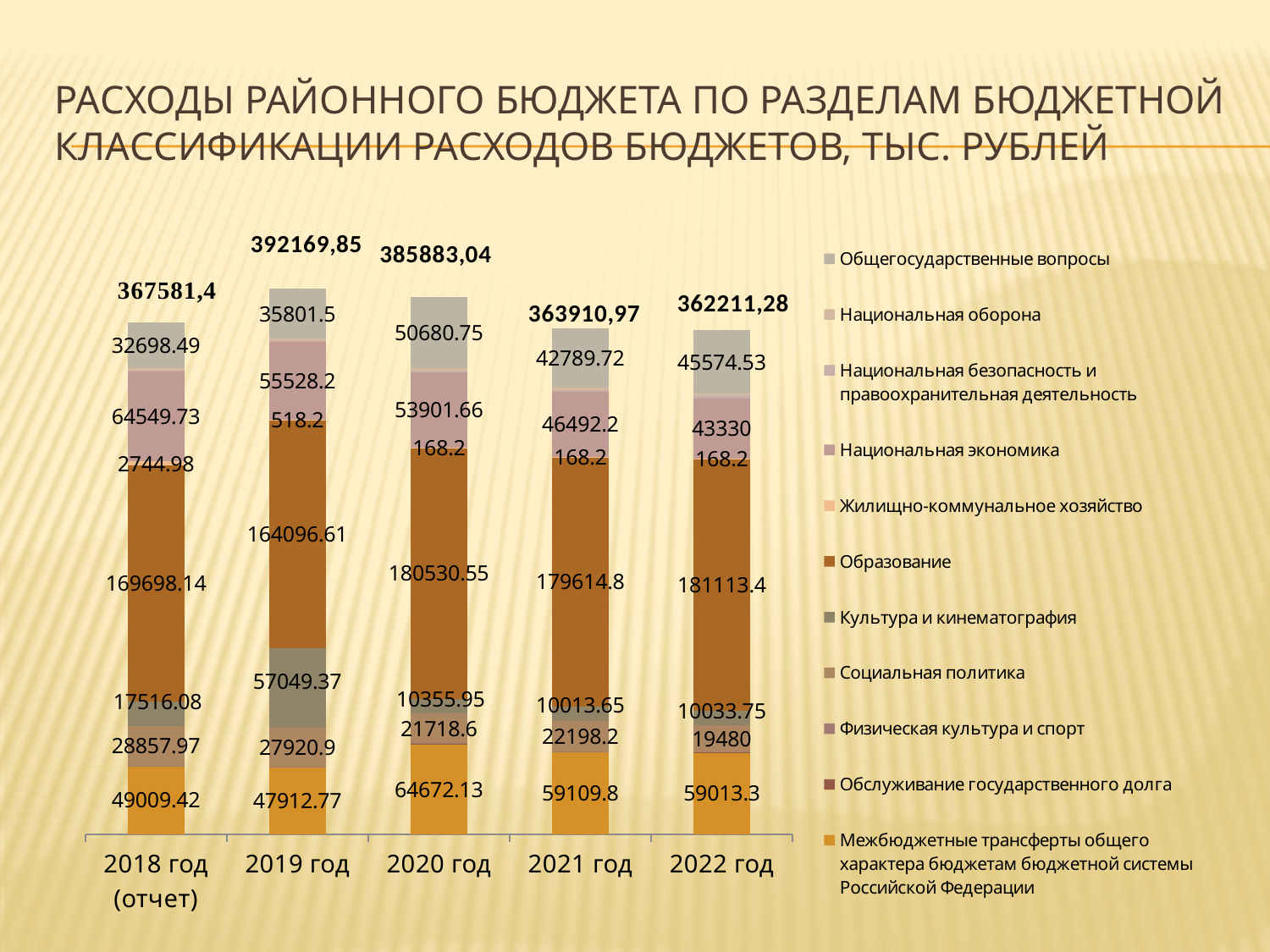
How many years are shown on the x axis? 5 In which year is the value for Образование the lowest? 2019 год What is the value for Межбюджетные трансферты общего характера бюджетам бюджетной системы Российской Федерации in 2021 год? 59109.8 What is the value for Образование in 2020 год? 180530.55 Which year has the lowest total expenditure? 2022 год How many series does the legend list? 11 What is the total for the 2018 год (отчет) bar? 367581,4 Which is larger: the value for Межбюджетные трансферты in 2020 год or in 2018 год (отчет)? 2020 год What is the difference between the total for 2019 год and the total for 2018 год (отчет)? 24588,45 What is the total for the 2019 год bar? 392169,85 What is the value for Общегосударственные вопросы in 2022 год? 45574.53 Which year has the highest total expenditure? 2019 год